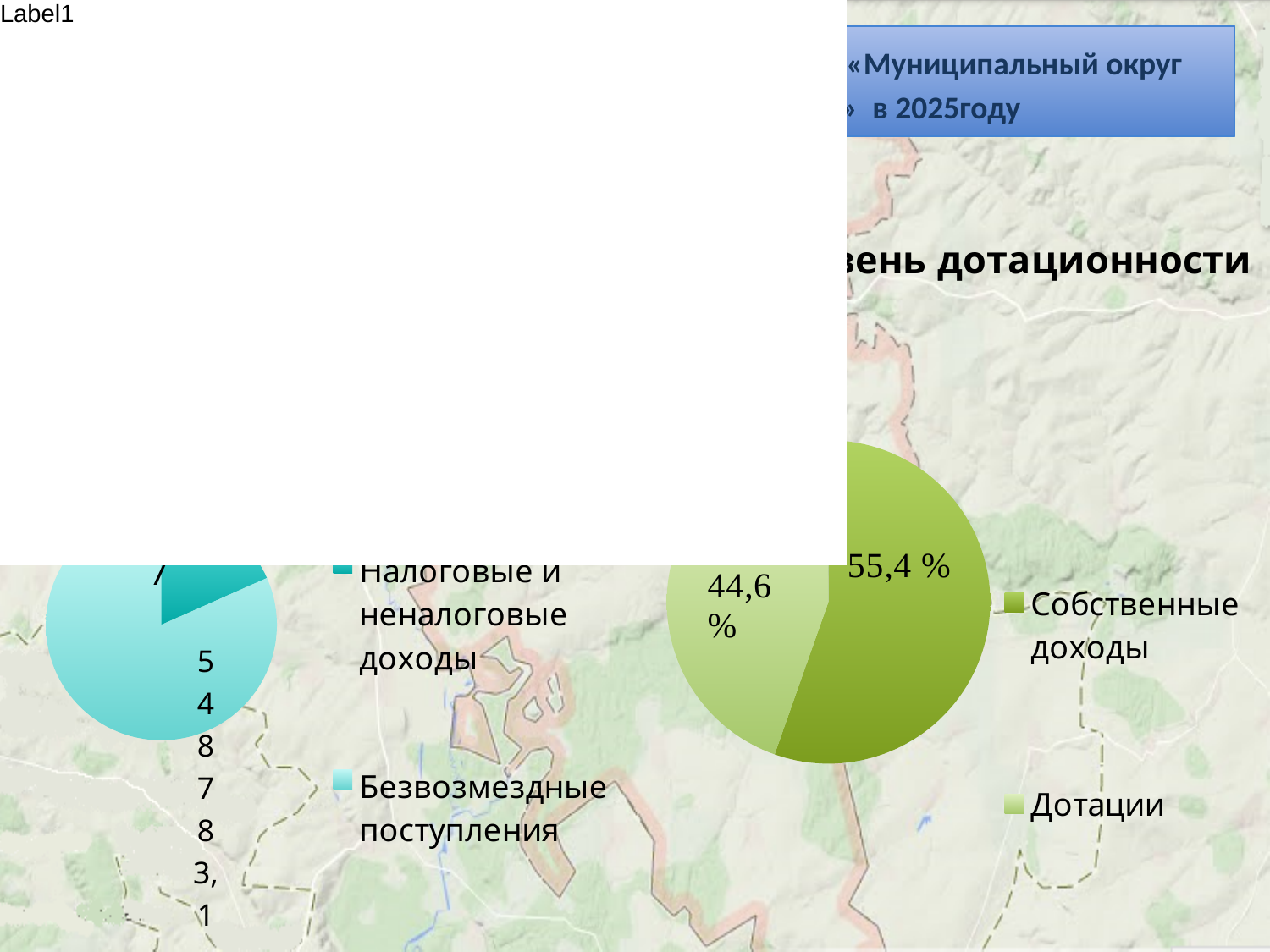
What kind of chart is the chart on the left side of the slide? pie chart In the right pie chart, which slice is the smallest? Дотации In the right pie chart, what share is labelled for Собственные доходы? 55,4 % In the left pie chart, which slice is the largest? Безвозмездные поступления In the right pie chart, which slice is the largest? Собственные доходы How many entries does the legend of the right pie chart list? 2 In the left pie chart, which is larger: Налоговые и неналоговые доходы or Безвозмездные поступления? Безвозмездные поступления In the right pie chart, what is the difference in percentage points between Собственные доходы and Дотации? 10,8 In the right pie chart, which is larger: Собственные доходы or Дотации? Собственные доходы What kind of chart is the chart on the right side of the slide? pie chart In the right pie chart, what share is labelled for Дотации? 44,6 % How many entries does the legend of the left pie chart list? 2